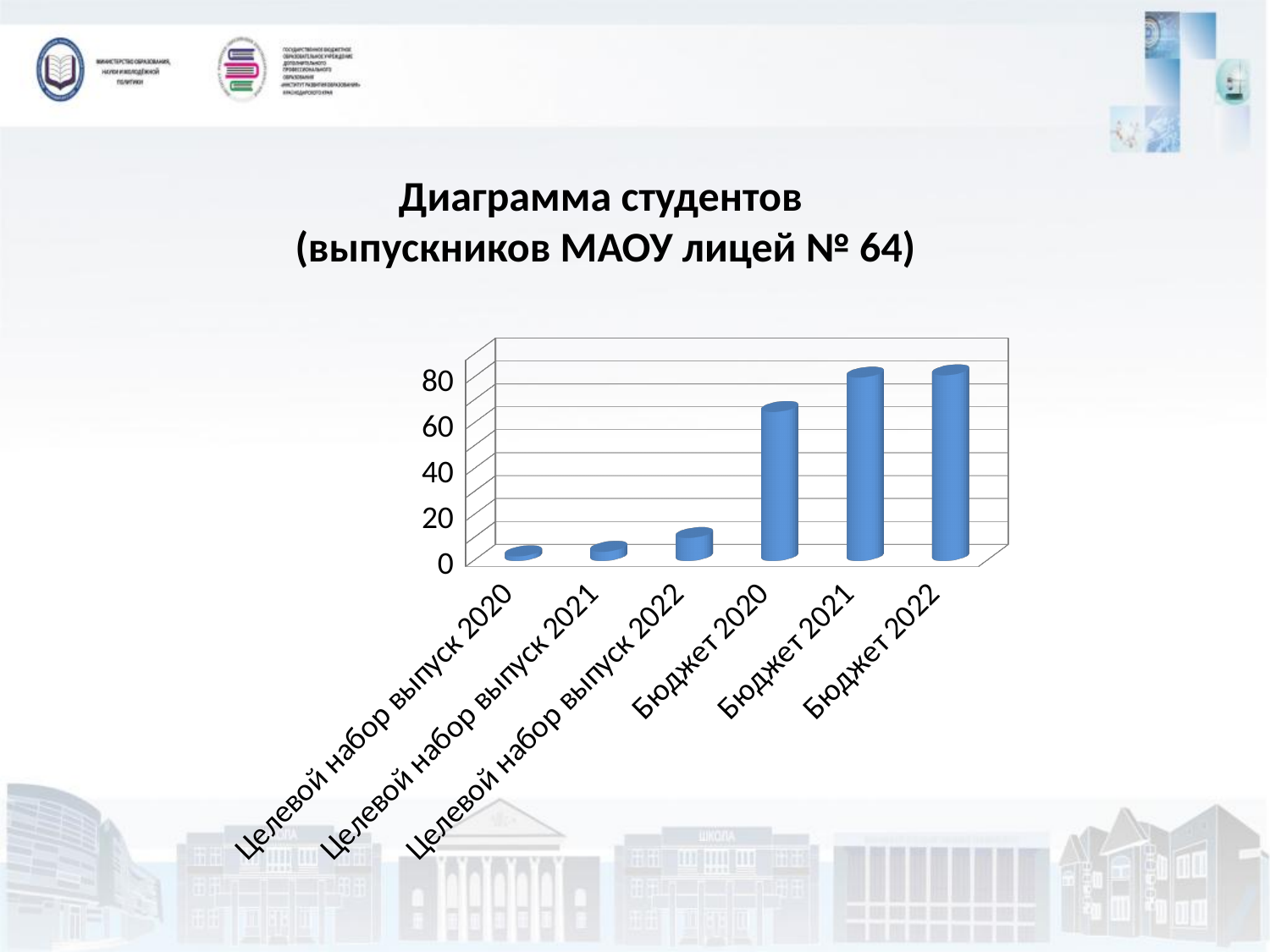
Which category has the lowest value on the chart? Целевой набор выпуск 2020 What is the title shown above the chart? Диаграмма студентов (выпускников МАОУ лицей № 64) Is the value for Целевой набор выпуск 2022 greater or less than 20? less Which is larger, the value for Бюджет 2021 or the value for Бюджет 2020? Бюджет 2021 Which is larger, the value for Бюджет 2020 or the value for Целевой набор выпуск 2020? Бюджет 2020 Do the values generally rise or fall from left to right along the x axis? rise Is the value for Бюджет 2021 greater or less than 60? greater Which is larger, the value for Целевой набор выпуск 2022 or the value for Целевой набор выпуск 2020? Целевой набор выпуск 2022 How many categories are plotted on the chart? 6 Is the value for Целевой набор выпуск 2021 greater or less than 20? less What kind of chart is shown on the slide? Bar chart